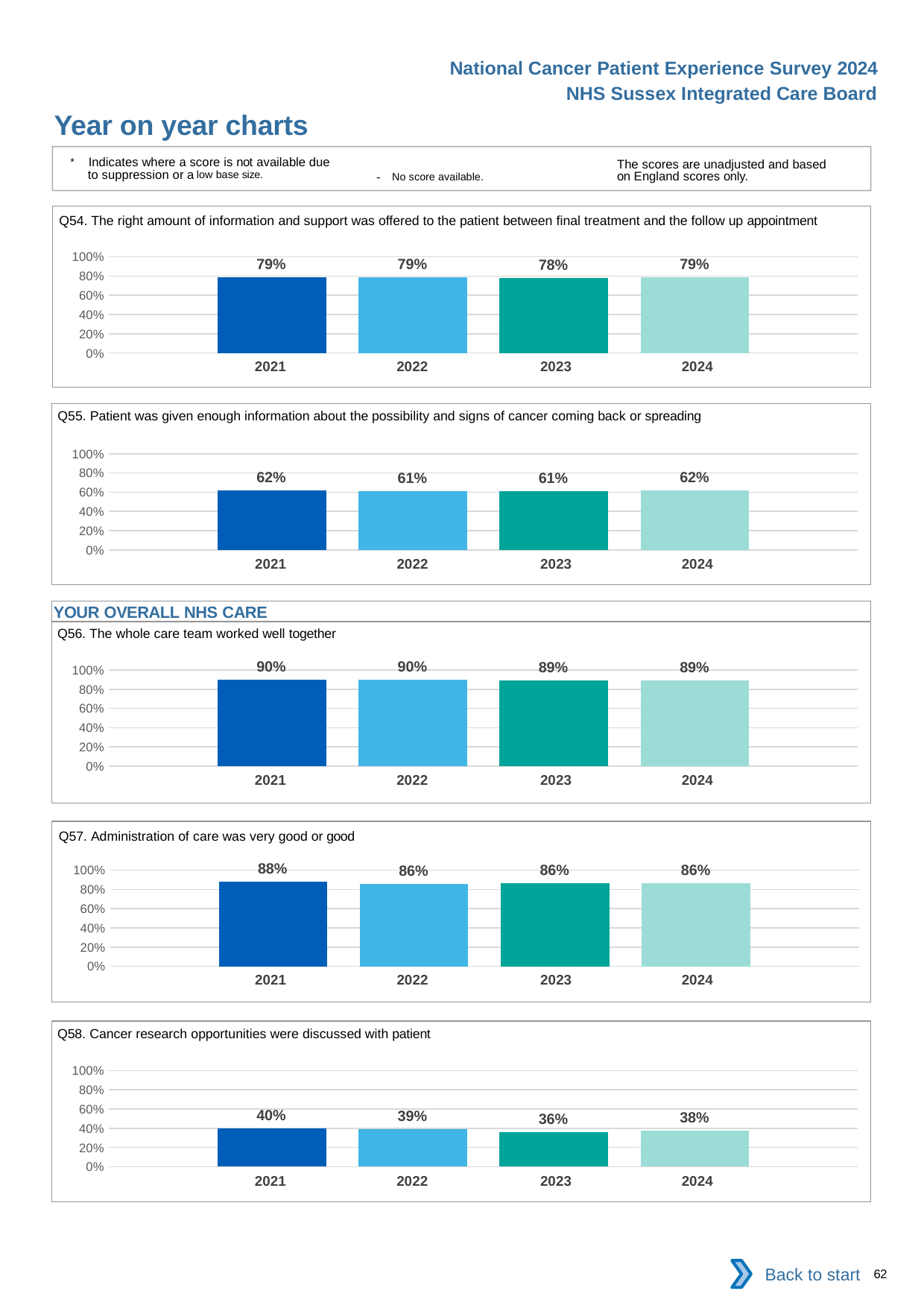
What kind of chart is the Q55 chart? bar chart In the Q58 chart, what is the difference between the 2021 and 2023 values? 4% How many charts are shown on the slide? 5 In the Q58 chart, which is larger, the value for 2022 or the value for 2023? 2022 In the Q56 chart, what is the value for 2021? 90% In the Q58 chart, which year has the lowest value? 2023 In the Q54 chart, what is the value for 2023? 78% In the Q55 chart, what is the value for 2024? 62% In the Q57 chart, which year has the highest value? 2021 How many years are shown in the Q56 chart? 4 In the Q58 chart, is the value for 2024 greater or less than 60%? less In the Q57 chart, what is the difference between the 2021 and 2022 values? 2%